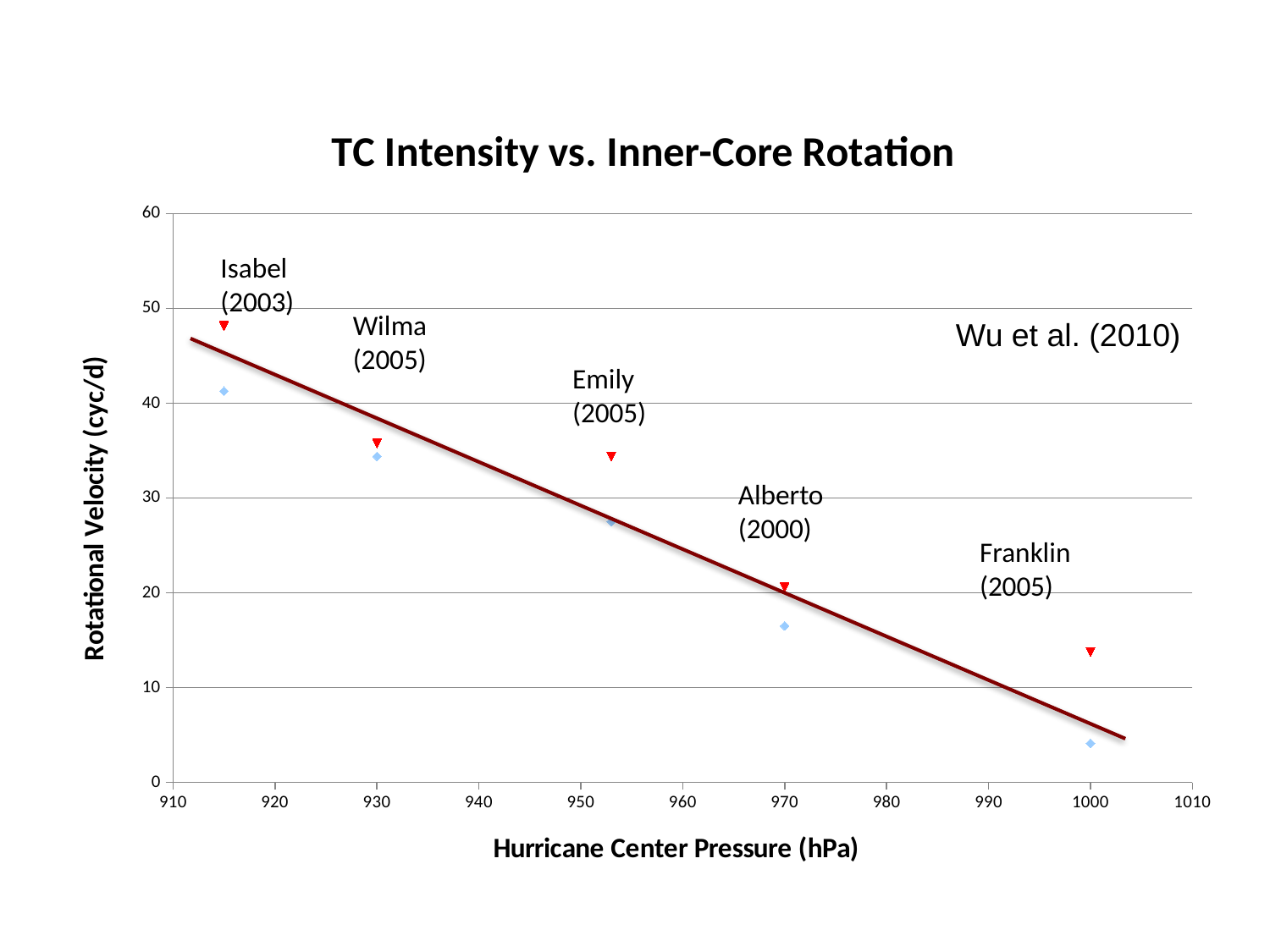
What kind of chart is shown on the slide? scatter chart Which has the higher rotational velocity, Emily (2005) or Franklin (2005)? Emily (2005) What is the title of the chart? TC Intensity vs. Inner-Core Rotation How many hurricanes are labeled on the chart? 5 Which labeled hurricane has the highest rotational velocity? Isabel (2003) What is the label of the x axis? Hurricane Center Pressure (hPa) Is the rotational velocity of the red triangle for Emily (2005) greater or less than 30? greater Which labeled hurricane has the lowest rotational velocity? Franklin (2005) As hurricane center pressure increases along the x axis, does rotational velocity rise or fall? fall Which has the higher rotational velocity, Wilma (2005) or Alberto (2000)? Wilma (2005) Is the rotational velocity of the blue diamond for Franklin (2005) greater or less than 10? less Is the rotational velocity of the red triangle for Isabel (2003) greater or less than 40? greater